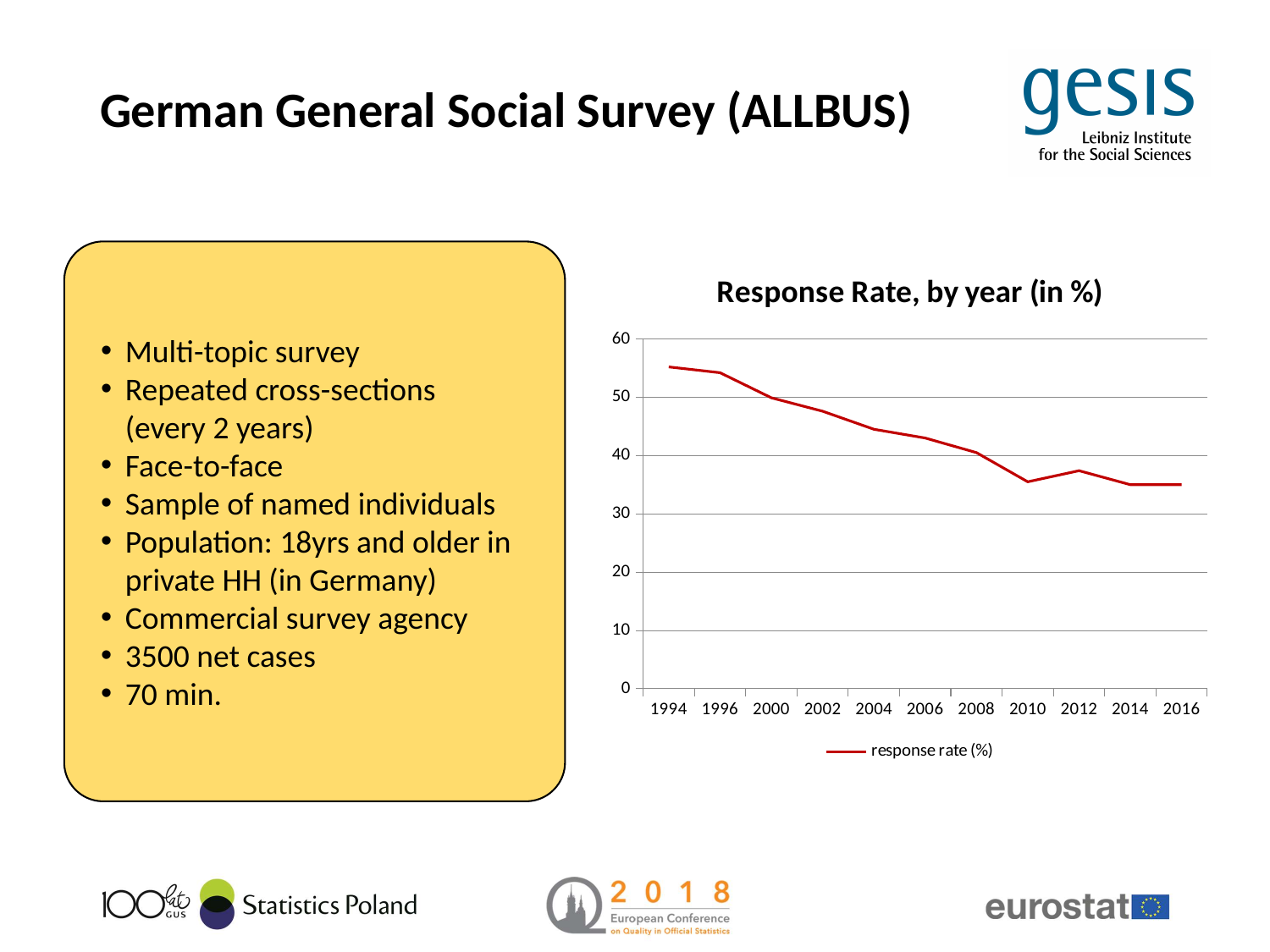
Which year has the larger response rate, 2004 or 2012? 2004 Is the response rate for 2004 greater or less than 40? greater Which year has the larger response rate, 1994 or 2016? 1994 What kind of chart is shown on the slide? line chart Which year has the highest response rate? 1994 What is the legend entry for the plotted line? response rate (%) Is the response rate for 2010 greater or less than 40? less Is the response rate for 2016 greater or less than 40? less What is the title of the chart? Response Rate, by year (in %) How many series does the chart's legend list? 1 Do the response rate values generally rise or fall from 1994 to 2016? fall